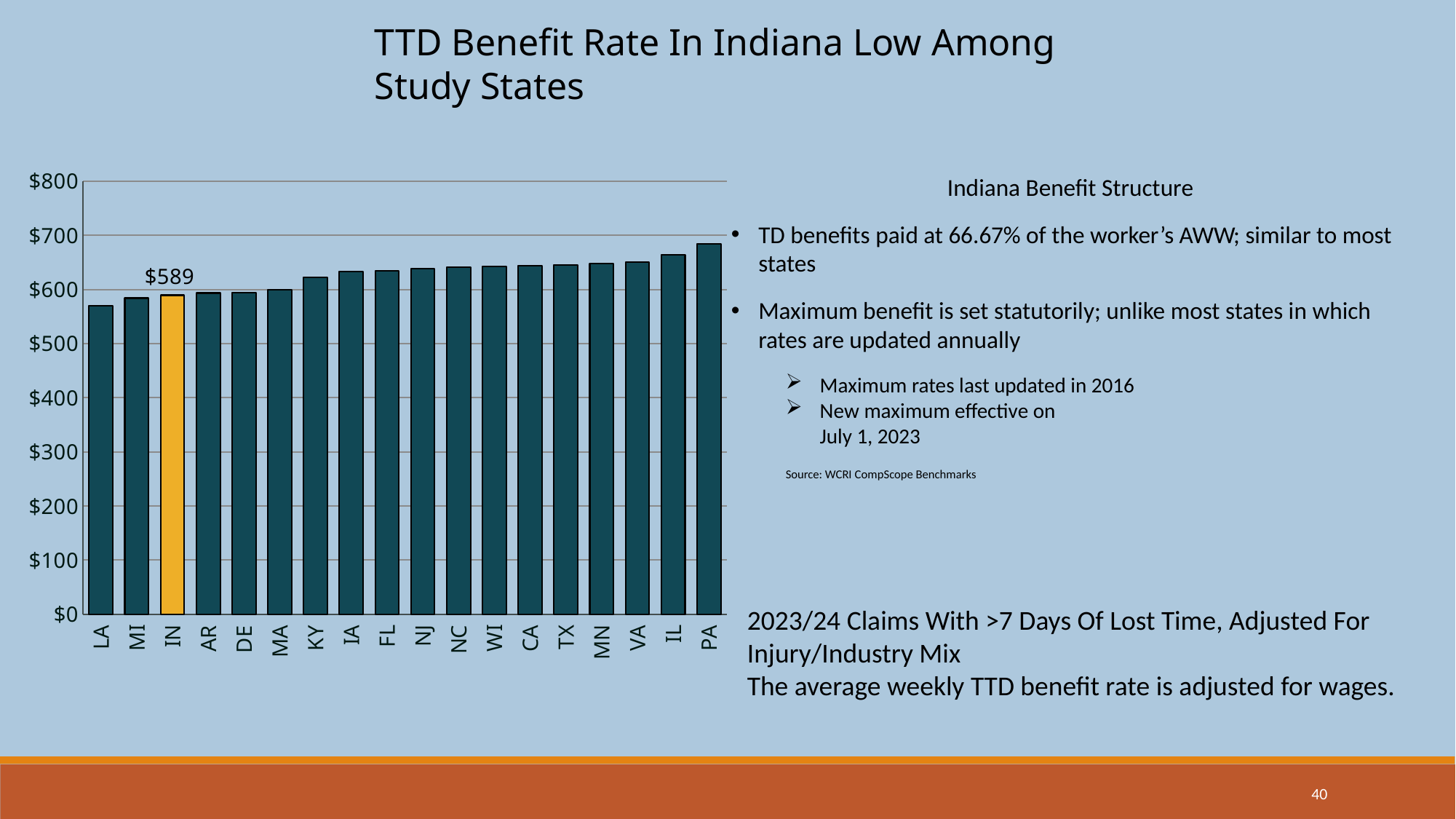
Is the value for PA greater or less than $600? greater Which state has the highest bar in the chart? PA Which has a larger value, LA or PA? PA Do the bar values rise or fall from left to right across the x axis? Rise Is the value for PA greater or less than $700? less Is the value for KY greater or less than $600? greater How many states are shown on the x axis of the chart? 18 What kind of chart is shown on the slide? Bar chart Which state's bar is highlighted in a different colour (orange) from the others? IN What is the TTD benefit rate shown for IN? $589 Which state has the lowest bar in the chart? LA